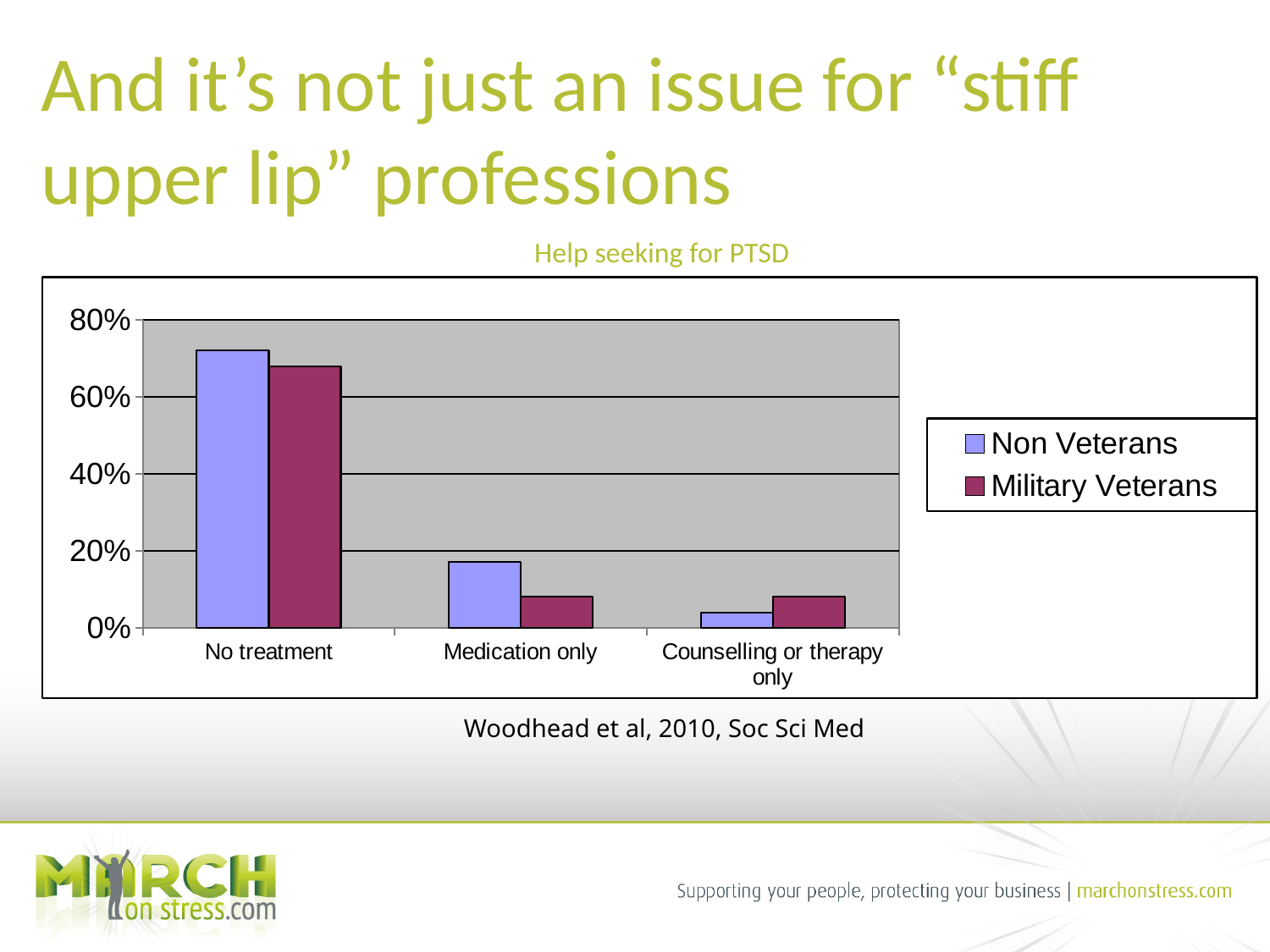
Which category has the highest value for Non Veterans? No treatment Is the Military Veterans value for Medication only greater or less than 20%? less Which category has the lowest value for Non Veterans? Counselling or therapy only For Medication only, which series has the larger value, Non Veterans or Military Veterans? Non Veterans For Counselling or therapy only, which series has the larger value, Non Veterans or Military Veterans? Military Veterans Is the Non Veterans value for No treatment greater or less than 60%? greater What is the title of the chart? Help seeking for PTSD How many categories are shown on the x axis of the chart? 3 What kind of chart is shown on the slide? bar chart Which category has the highest value for Military Veterans? No treatment How many series does the chart legend list? 2 Which series is shown in the dark red/purple colour in the chart? Military Veterans